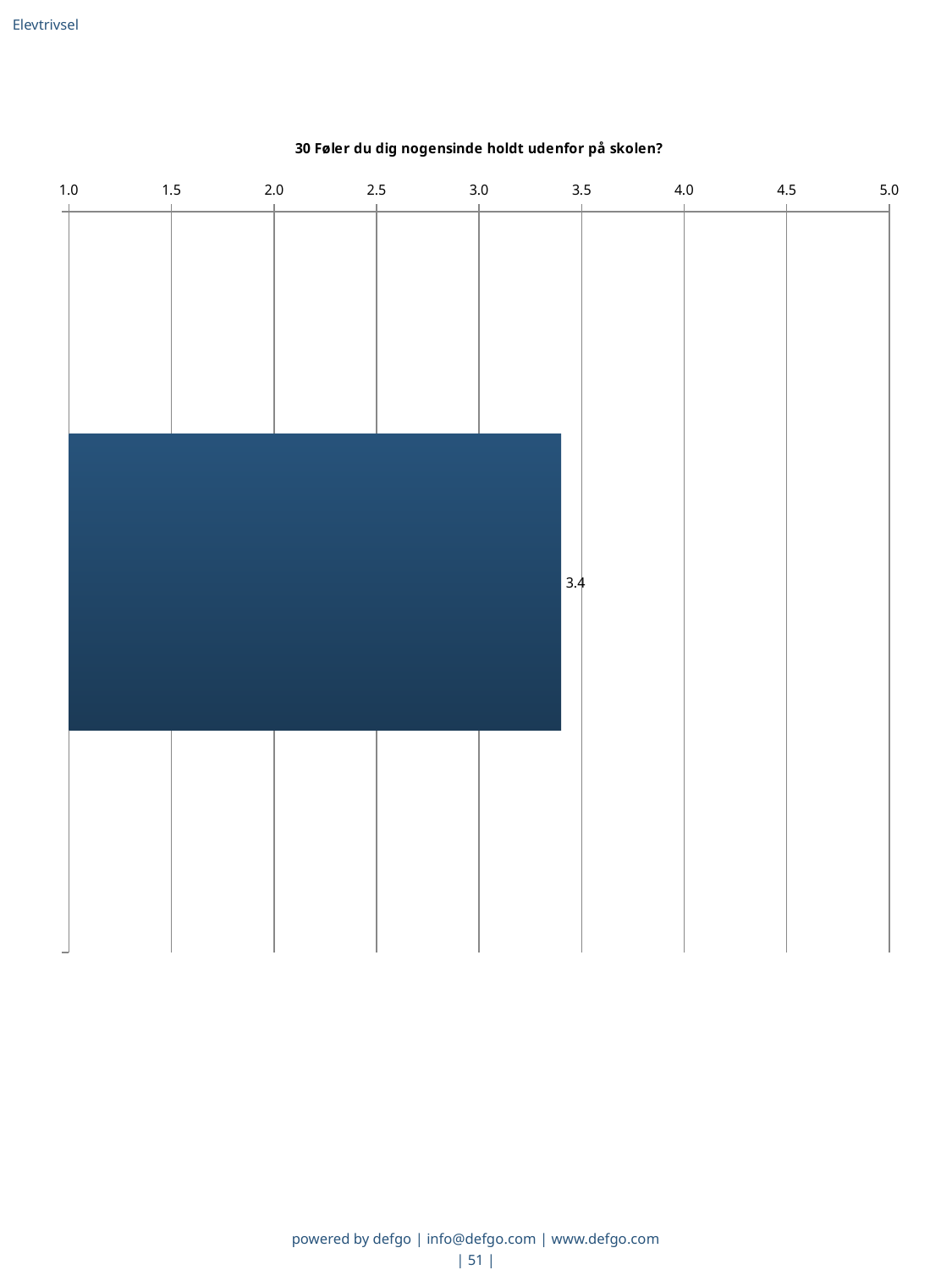
Is the value of the bar greater or less than 3.0? greater What is the title of the chart? 30 Føler du dig nogensinde holdt udenfor på skolen? Is the value of the bar greater or less than 4.0? less What is the value shown by the bar in the chart? 3.4 What is the maximum value shown on the chart's axis? 5.0 What kind of chart is shown on the slide? bar chart How many bars are plotted in the chart? 1 Is the bar in the chart horizontal or vertical? horizontal